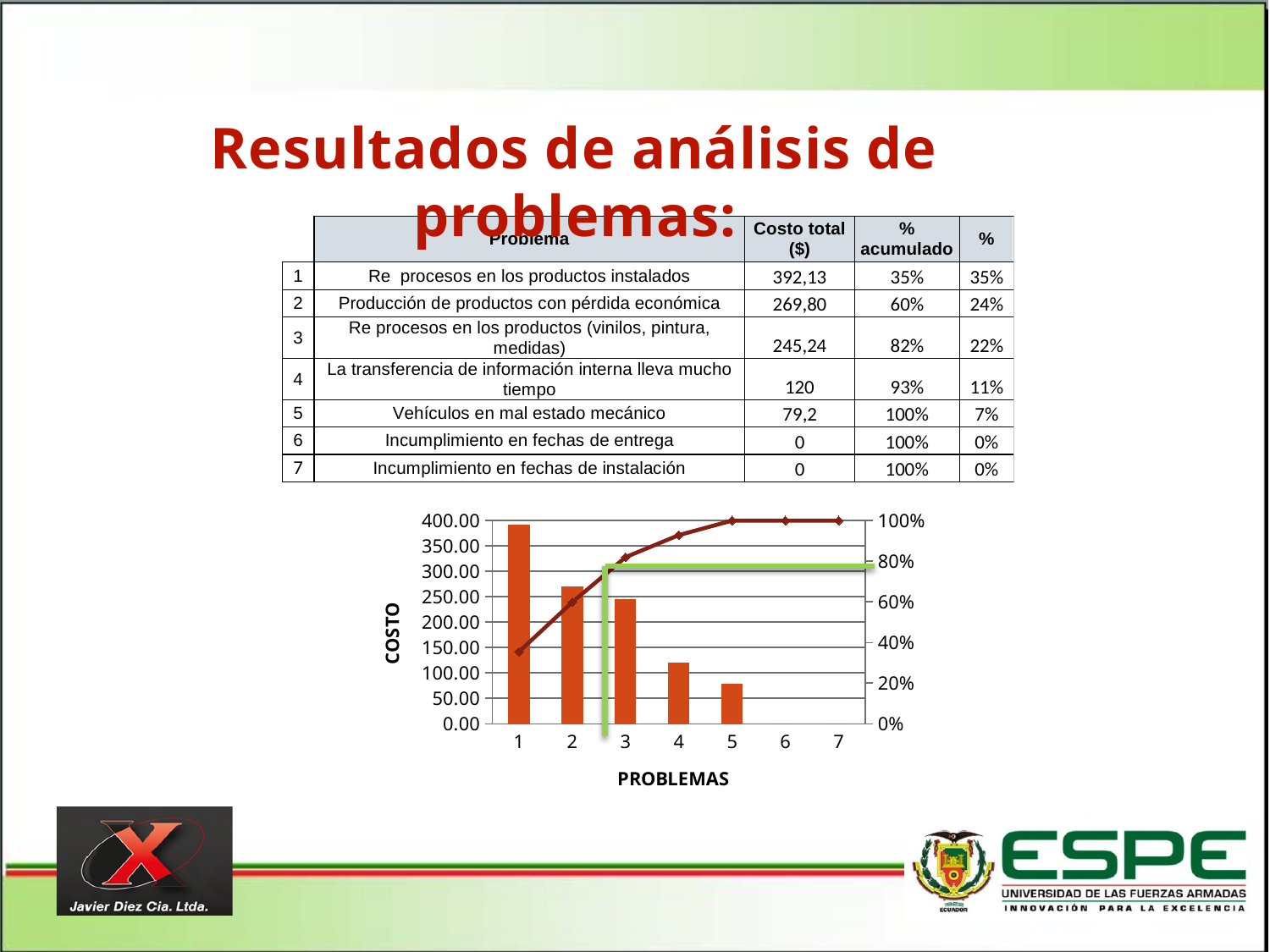
Which bar is taller, problem 1 or problem 2? problem 1 What kind of chart is shown on the slide? bar chart with a line How many problems (categories) are shown along the x axis of the chart? 7 According to the table, what is the % acumulado at problem 3? 82% Is the bar for problem 5 greater or less than 100.00? less According to the table, what is the Costo total ($) for problem 1, Re procesos en los productos instalados? 392,13 What is the title of the x axis of the chart? PROBLEMAS Is the bar for problem 4 greater or less than 150.00? less Is the bar for problem 1 greater or less than 350.00? greater Which problem number has the tallest bar in the chart? 1 Do the bar heights rise or fall from problem 1 to problem 5 along the x axis? fall Which problem numbers have no visible bar (a cost of 0) in the chart? 6 and 7